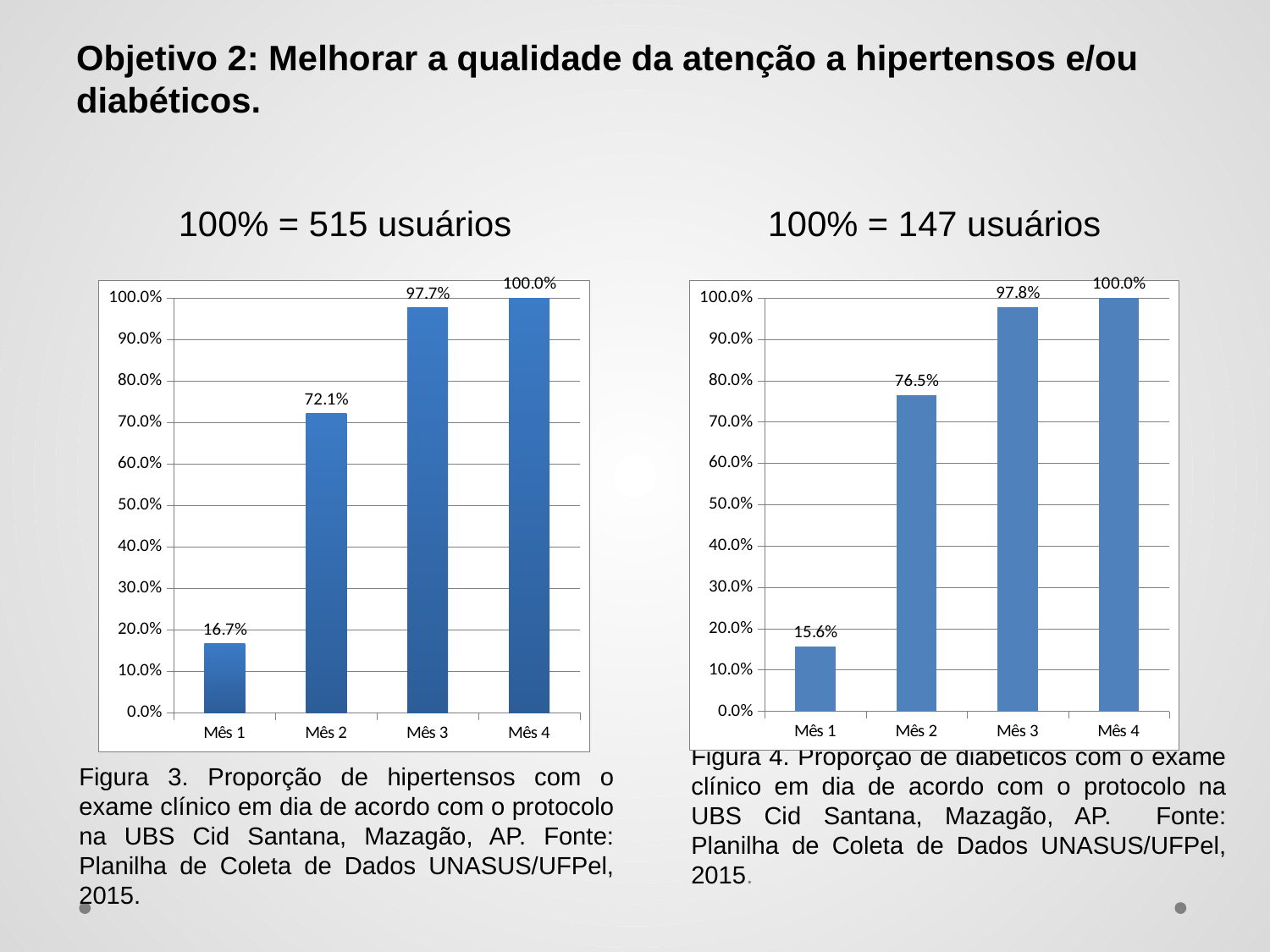
In the right chart (Figura 4, diabéticos), what is the value for Mês 1? 15.6% In the left chart (Figura 3, hipertensos), what is the difference between Mês 2 and Mês 1? 55.4% In the right chart (Figura 4, diabéticos), which month has the highest value? Mês 4 In the right chart (Figura 4, diabéticos), do the values rise or fall from Mês 1 to Mês 4? Rise In the left chart (Figura 3, hipertensos), which month has the lowest value? Mês 1 Which is larger: Mês 2 in the left chart (hipertensos) or Mês 2 in the right chart (diabéticos)? Mês 2 in the right chart (diabéticos) How many months (categories) are shown in the right chart (Figura 4, diabéticos)? 4 What kind of chart is the left chart (Figura 3, hipertensos)? Bar chart In the left chart (Figura 3, hipertensos), is the value for Mês 3 greater or less than 90.0%? greater In the left chart (Figura 3, hipertensos), what is the value for Mês 2? 72.1% In the right chart (Figura 4, diabéticos), what is the difference between Mês 3 and Mês 2? 21.3% According to the text above the right chart, how many users correspond to 100% for the diabéticos chart? 147 usuários